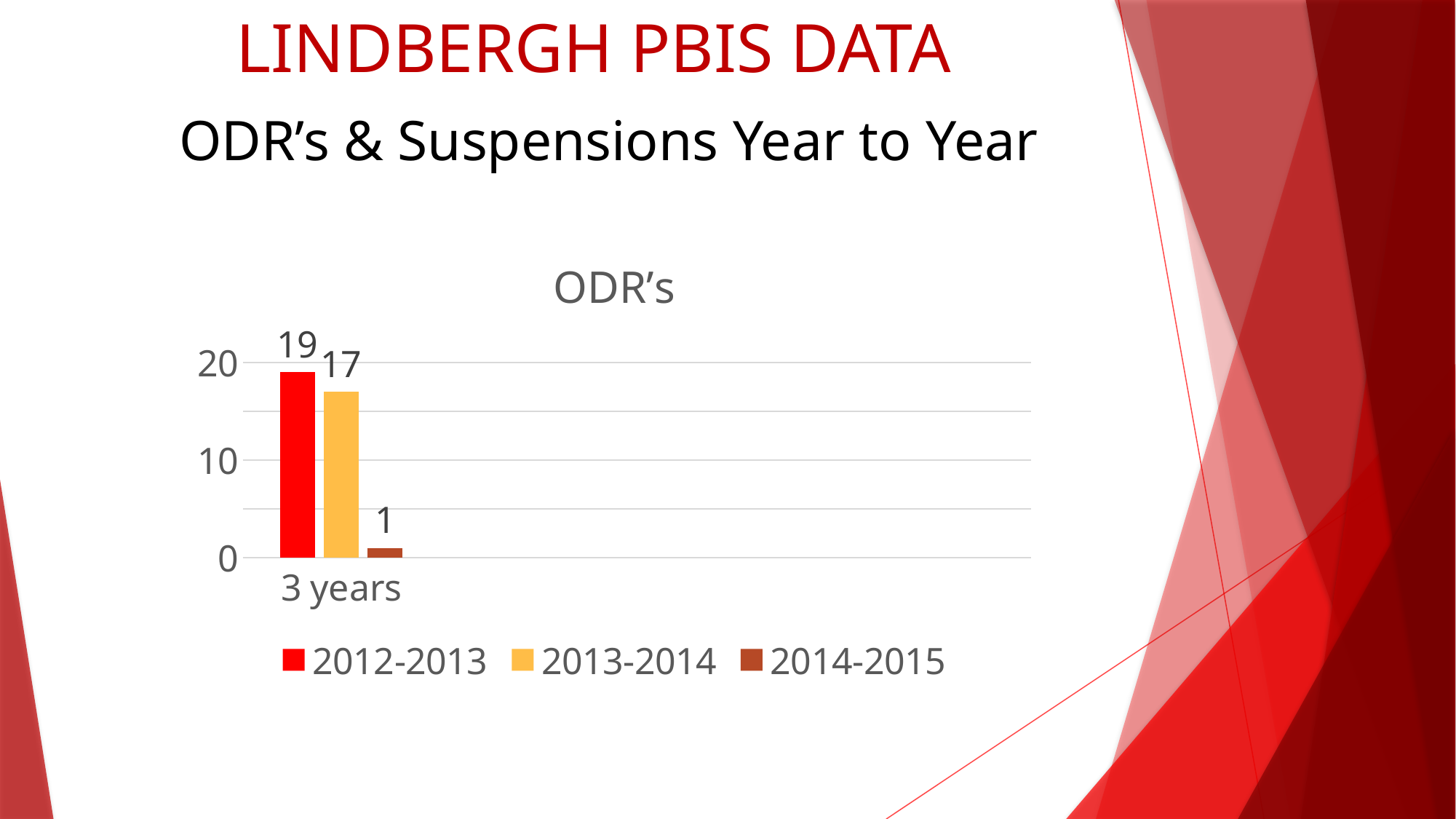
What is the difference between the 2012-2013 and 2013-2014 values in the ODR's chart? 2 Which is larger in the ODR's chart, the value for 2012-2013 or 2014-2015? 2012-2013 What is the difference between the 2013-2014 and 2014-2015 values in the ODR's chart? 16 What is the value for 2013-2014 in the ODR's chart? 17 What is the category label on the x axis of the ODR's chart? 3 years Which series has the highest value in the ODR's chart? 2012-2013 What is the value for 2012-2013 in the ODR's chart? 19 What is the value for 2014-2015 in the ODR's chart? 1 Which series has the lowest value in the ODR's chart? 2014-2015 What kind of chart is the ODR's chart? bar chart Is the value for 2013-2014 in the ODR's chart greater or less than 10? greater How many series does the legend of the ODR's chart list? 3